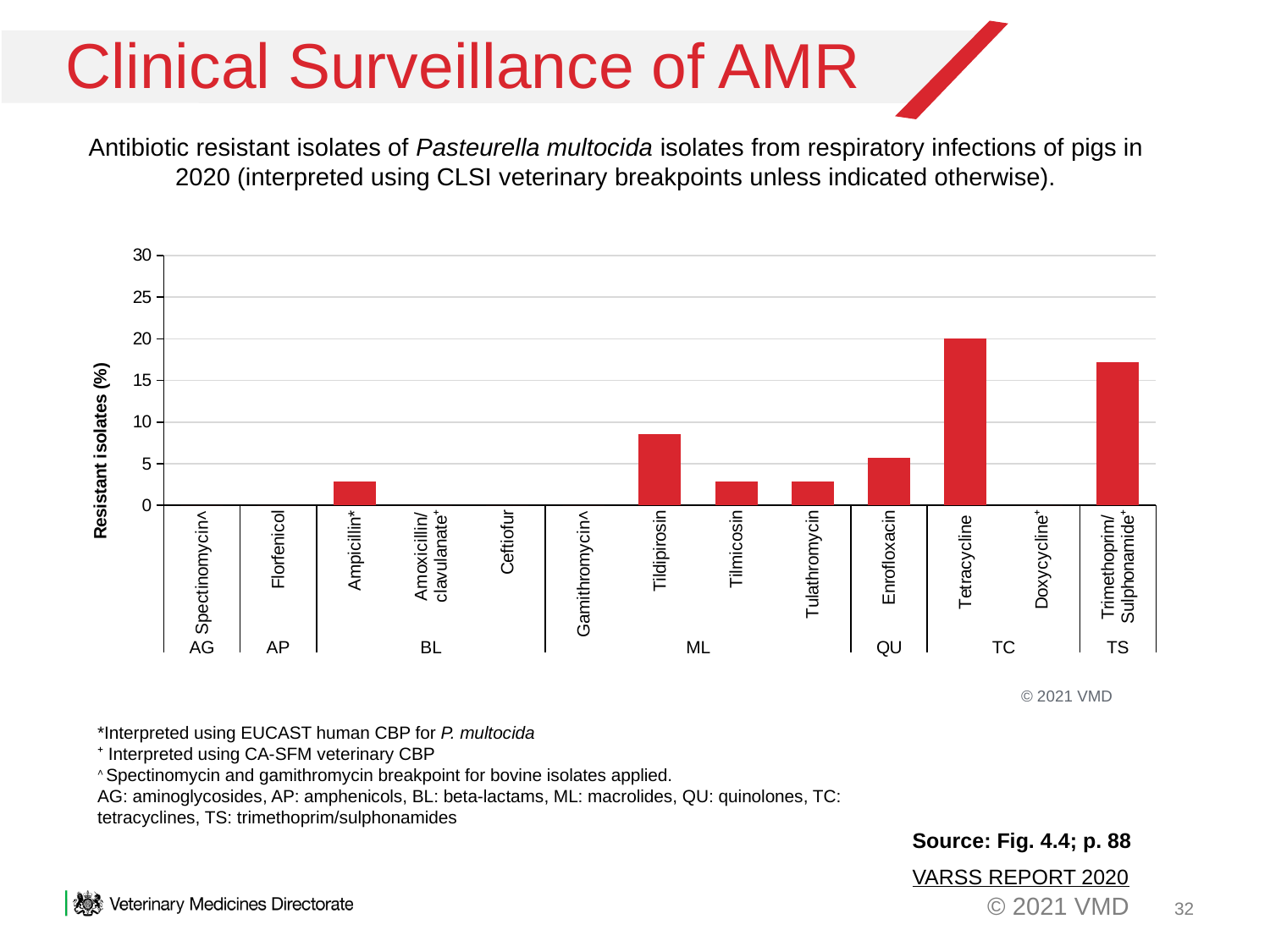
How many antibiotics are shown on the x axis of the chart? 13 What is the percentage of resistant isolates for Florfenicol? 0 Which has a higher percentage of resistant isolates, Tildipirosin or Tilmicosin? Tildipirosin What kind of chart is shown on the slide? bar chart Is the value for Enrofloxacin greater or less than 10? less Which has a higher percentage of resistant isolates, Enrofloxacin or Tulathromycin? Enrofloxacin Which antibiotic has the highest percentage of resistant isolates? Tetracycline Is the value for Trimethoprim/Sulphonamide greater or less than 15? greater Which has a higher percentage of resistant isolates, Tetracycline or Trimethoprim/Sulphonamide? Tetracycline What is the label of the y axis? Resistant isolates (%) Is the value for Tildipirosin greater or less than 5? greater